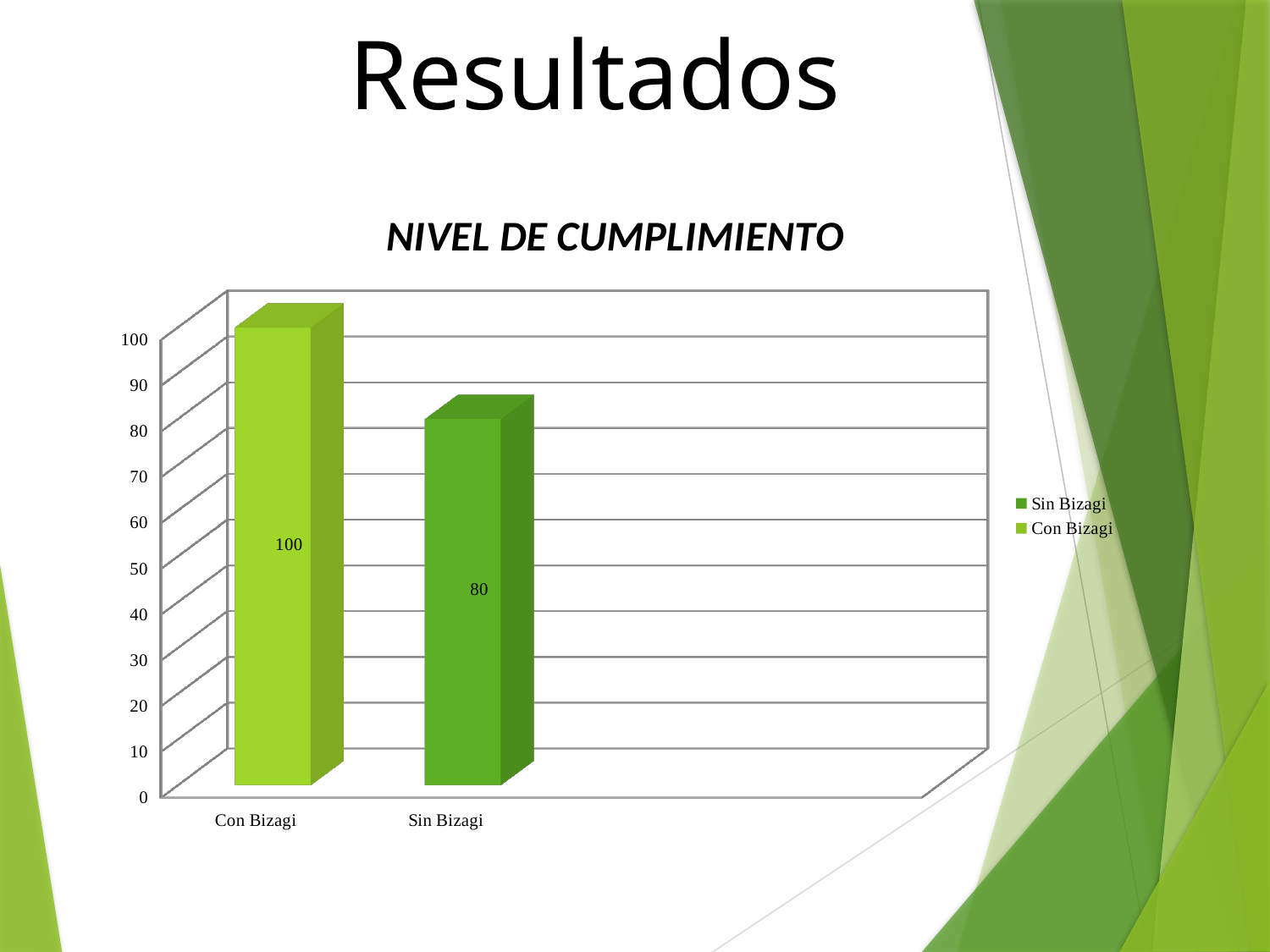
What kind of chart is shown on the slide? bar chart How many entries does the legend list? 2 How many categories are shown on the x axis? 2 What is the value for Sin Bizagi? 80 What is the difference between the values for Con Bizagi and Sin Bizagi? 20 What is the highest value shown on the vertical axis? 100 What is the title of the chart? NIVEL DE CUMPLIMIENTO Which category has the highest value? Con Bizagi What is the value for Con Bizagi? 100 Which category has the lowest value? Sin Bizagi Is the value for Sin Bizagi greater or less than 90? less Which is larger, the value for Con Bizagi or the value for Sin Bizagi? Con Bizagi